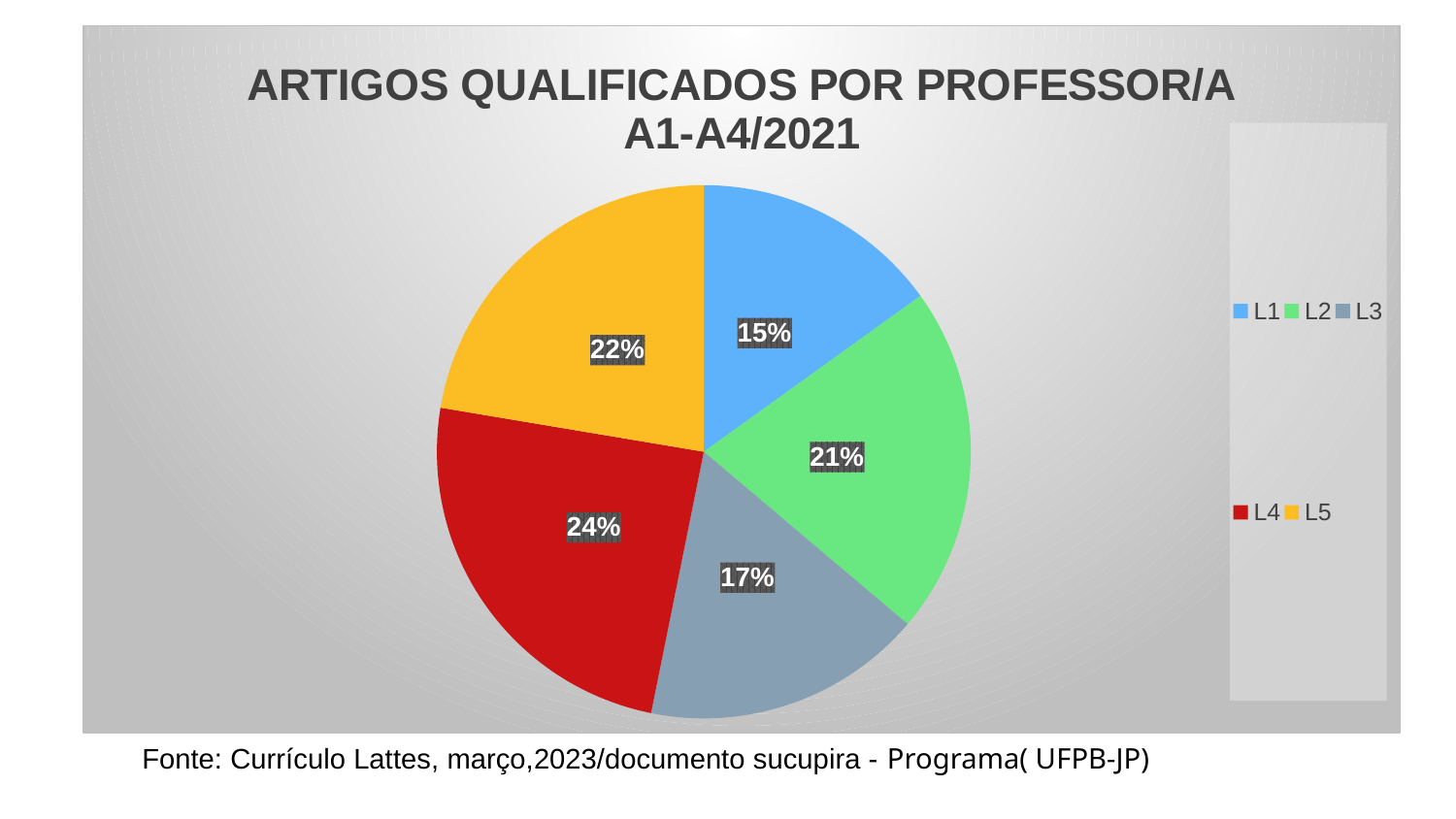
Which has a larger share, L2 or L3? L2 What is the share for L3? 17% What is the share for L2? 21% What is the share for L5? 22% How many slices does the pie chart have? 5 What is the share for L1? 15% What kind of chart is shown on the slide? pie chart Which category has the largest share of the pie? L4 What is the difference in percentage points between L4 and L1? 9 What is the title of the chart? ARTIGOS QUALIFICADOS POR PROFESSOR/A A1-A4/2021 What is the share for L4? 24% Which category has the smallest share of the pie? L1